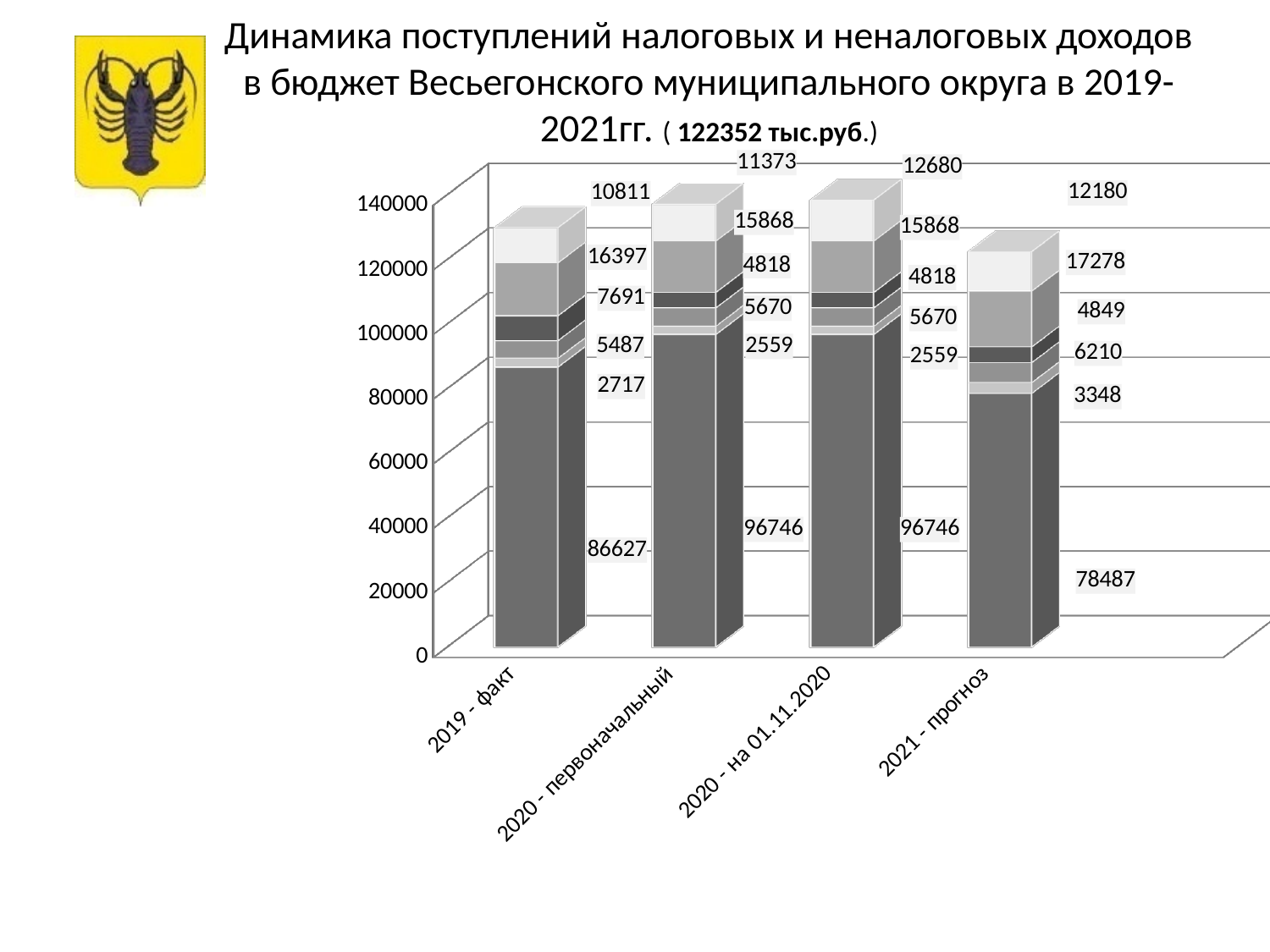
What is the value of the bottom (largest) segment of the bar for 2020 - первоначальный? 96746 How many categories are shown on the x axis of the chart? 4 What kind of chart is shown on the slide? stacked bar chart What is the value of the bottom (largest) segment of the bar for 2021 - прогноз? 78487 What is the value of the top segment of the bar for 2020 - на 01.11.2020? 12680 Is the bottom segment of the bar for 2020 - первоначальный larger or smaller than the bottom segment for 2021 - прогноз? larger What is the value of the bottom (largest) segment of the bar for 2019 - факт? 86627 What total amount in тыс.руб. is stated in the chart title? 122352 тыс.руб. What is the total of the stacked bar for 2019 - факт? 129730 Which category has the lowest value for the bottom (largest) segment? 2021 - прогноз What is the total of the stacked bar for 2021 - прогноз? 122352 What is the difference between the bottom segment values for 2020 - первоначальный (96746) and 2019 - факт (86627)? 10119